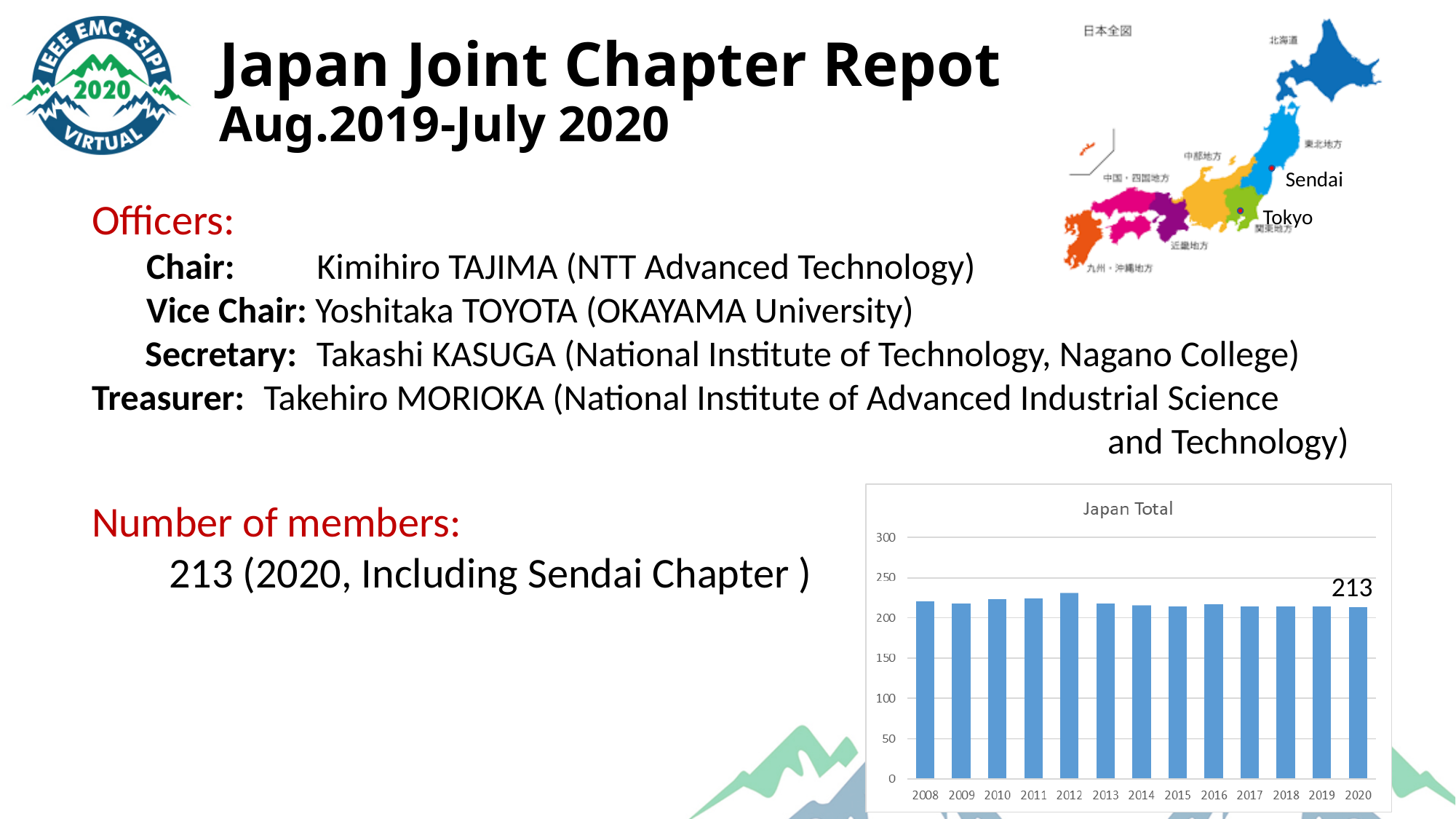
What is the first year shown on the x axis of the "Japan Total" chart? 2008 Is the value for 2012 in the "Japan Total" chart greater or less than 250? less In the "Japan Total" chart, which is larger, the value for 2012 or the value for 2014? 2012 Which year has the highest value in the "Japan Total" chart? 2012 In the "Japan Total" chart, which is larger, the value for 2012 or the value for 2020? 2012 What is the title of the chart on the slide? Japan Total What is the value for 2020 in the "Japan Total" chart? 213 In the "Japan Total" chart, do the values rise or fall from 2012 to 2020? fall What kind of chart is the "Japan Total" chart? bar chart How many years are shown on the x axis of the "Japan Total" chart? 13 Is the value for 2008 in the "Japan Total" chart greater or less than 200? greater Is the value for 2015 in the "Japan Total" chart greater or less than 150? greater